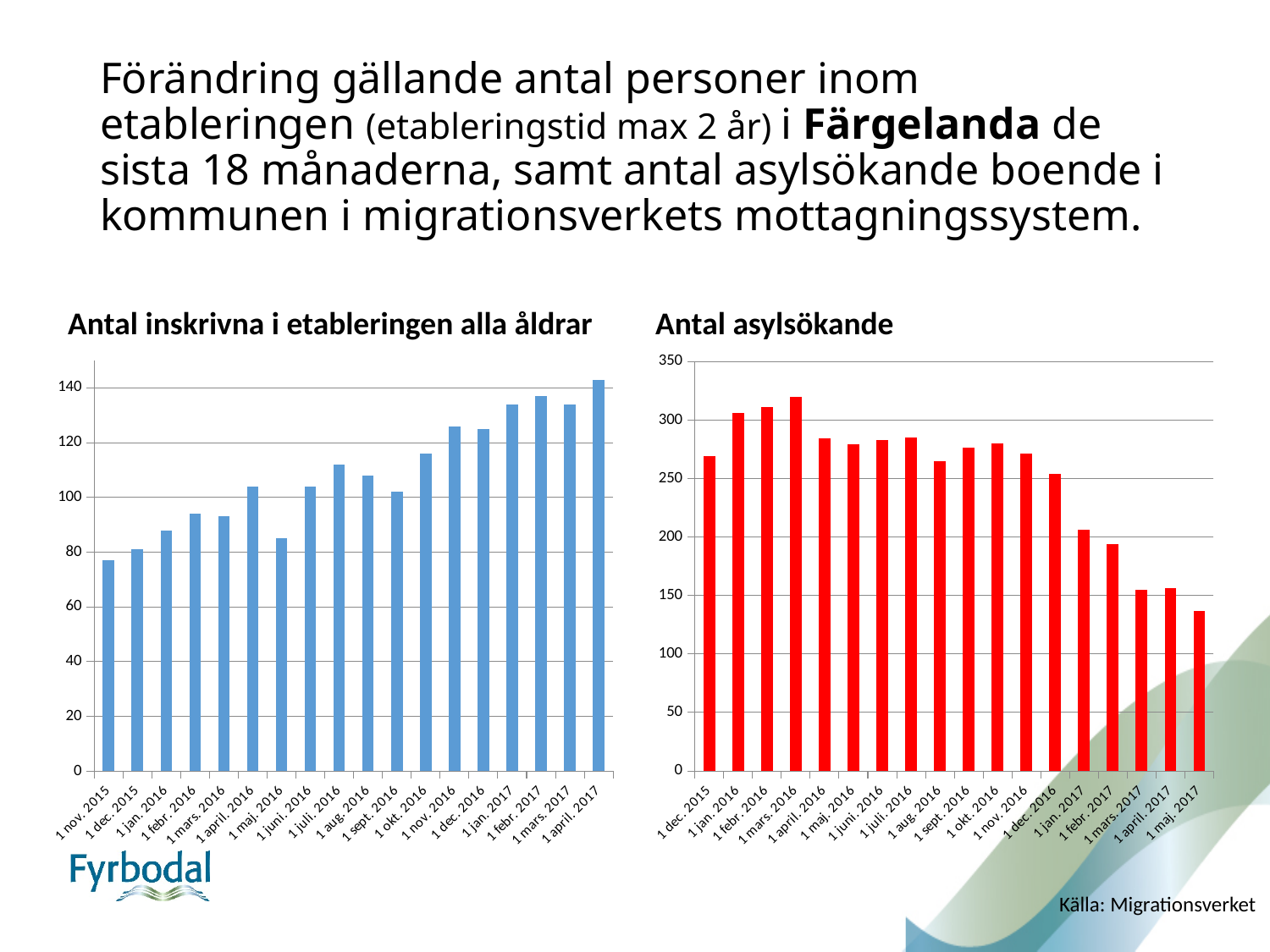
How many bars (months) are plotted in the 'Antal asylsökande' chart on the right? 18 In the 'Antal inskrivna i etableringen alla åldrar' chart, which is larger: the value for 1 april 2016 or for 1 maj 2016? 1 april 2016 In the 'Antal asylsökande' chart, which month has the lowest value? 1 maj 2017 In the 'Antal asylsökande' chart, is the value for 1 mars 2016 greater or less than 300? greater In the 'Antal inskrivna i etableringen alla åldrar' chart, which month has the highest value? 1 april 2017 In the 'Antal inskrivna i etableringen alla åldrar' chart, is the value for 1 april 2017 greater or less than 140? greater What kind of chart is the 'Antal inskrivna i etableringen alla åldrar' chart on the left? bar chart In the 'Antal asylsökande' chart, is the value for 1 maj 2017 greater or less than 150? less In the 'Antal inskrivna i etableringen alla åldrar' chart, which month has the lowest value? 1 nov. 2015 In the 'Antal asylsökande' chart, do the values generally rise or fall from left to right along the x axis? fall What colour are the bars in the 'Antal asylsökande' chart? red In the 'Antal asylsökande' chart, which month has the highest value? 1 mars 2016